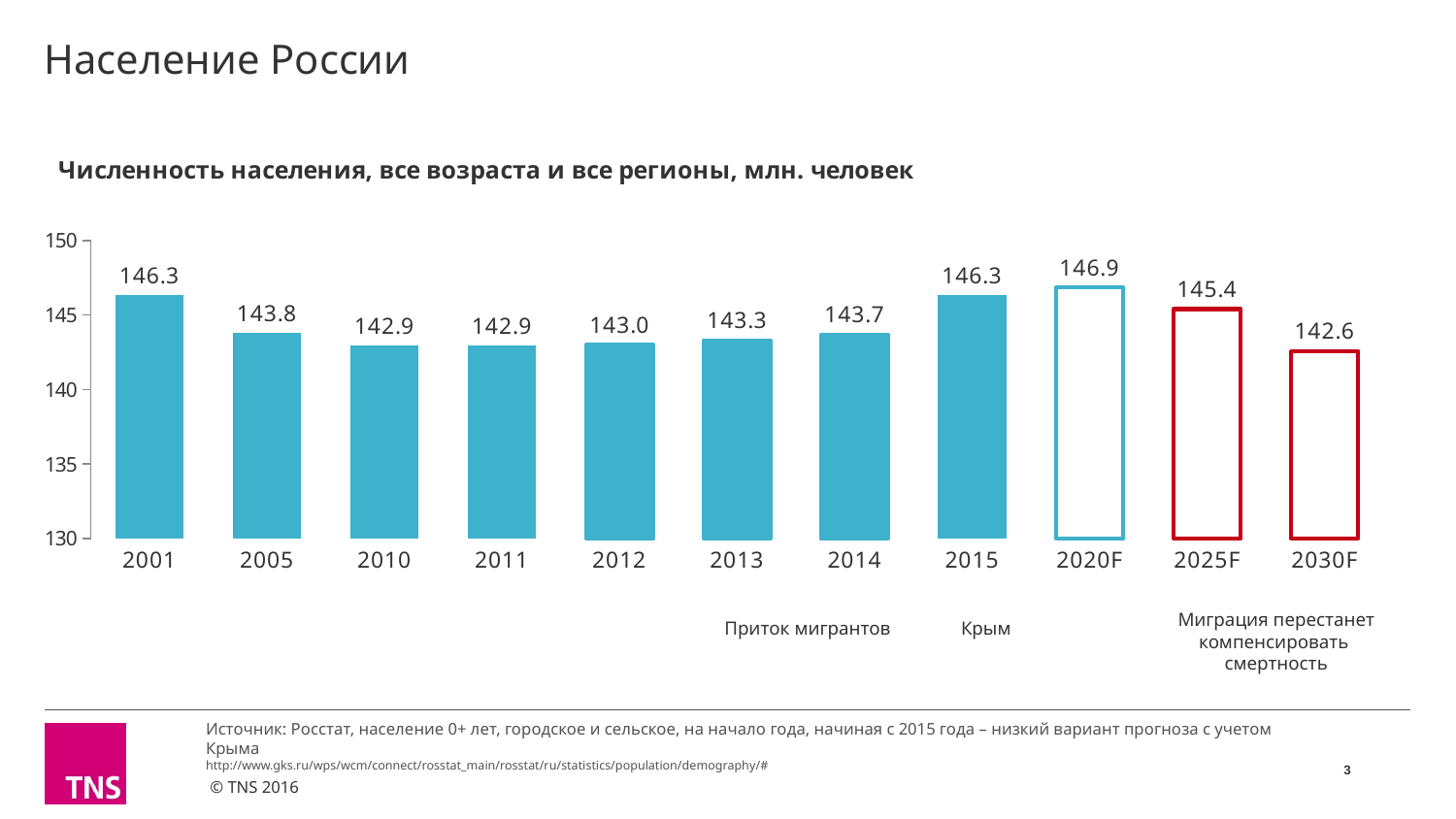
Is the value for 2012 greater or less than 145? less Which year has the lowest value on the chart? 2030F Which is larger, the value for 2014 or the value for 2025F? 2025F What is the difference between the values for 2020F and 2030F? 4.3 What kind of chart is shown on the slide? bar chart What is the value shown for 2010? 142.9 What is the population value shown for 2015? 146.3 What is the value shown for 2030F? 142.6 What is the difference between the values for 2001 and 2005? 2.5 How many years (bars) are shown on the chart? 11 What is the title of the chart? Численность населения, все возраста и все регионы, млн. человек Which year has the highest value on the chart? 2020F